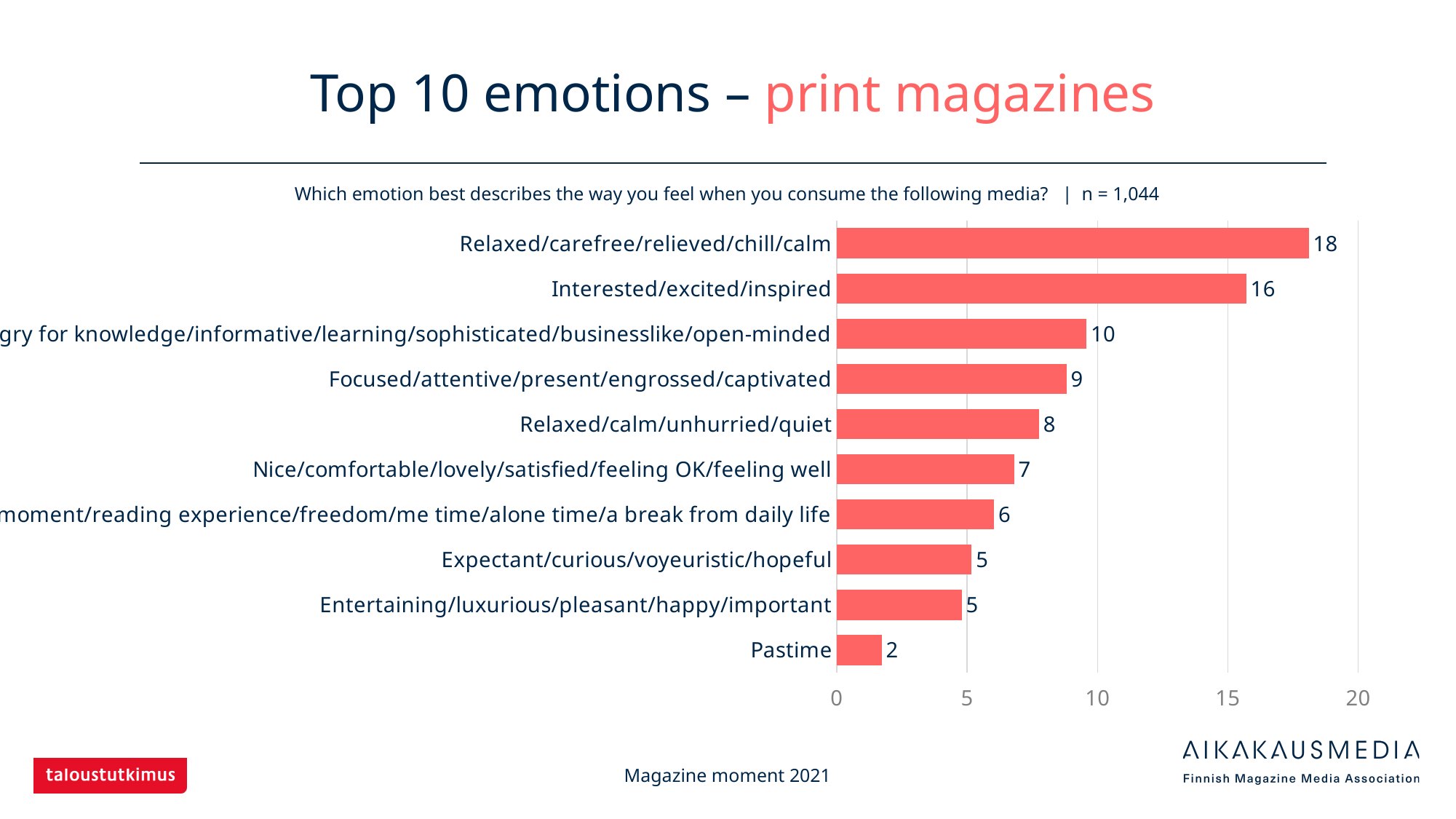
Is the value for Interested/excited/inspired greater or less than 15? greater What is the sample size (n) stated above the chart? 1,044 What is the difference between the values for Relaxed/carefree/relieved/chill/calm and Interested/excited/inspired? 2 Which category has the highest value? Relaxed/carefree/relieved/chill/calm What is the value for Pastime? 2 What kind of chart is shown on the slide? bar chart Which category has the lowest value? Pastime How many categories are shown in the chart? 10 What is the value for Relaxed/carefree/relieved/chill/calm? 18 What is the value for Focused/attentive/present/engrossed/captivated? 9 What is the value for Interested/excited/inspired? 16 Which is larger, the value for Relaxed/calm/unhurried/quiet or the value for Expectant/curious/voyeuristic/hopeful? Relaxed/calm/unhurried/quiet